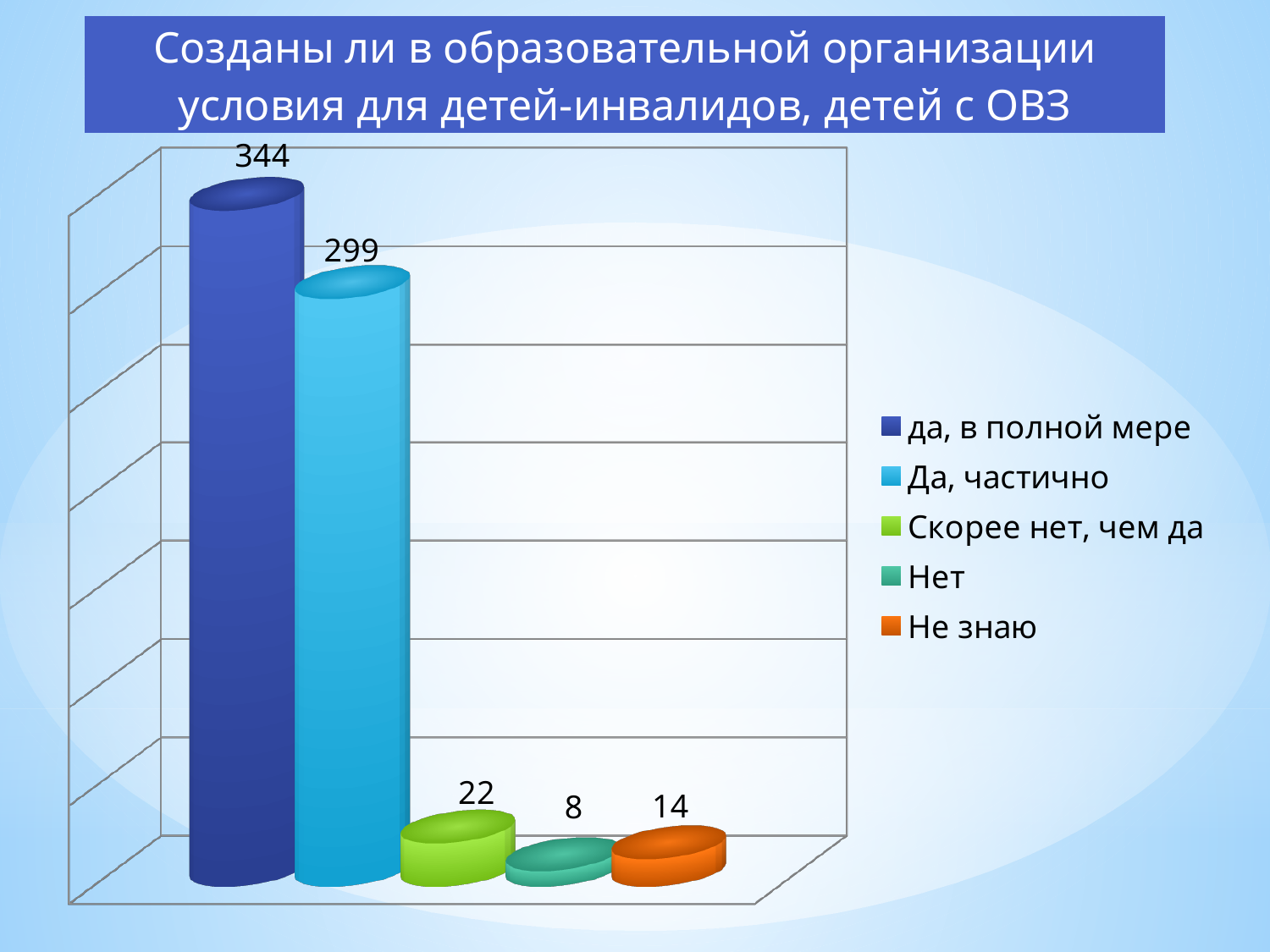
Which is larger, the value for "Не знаю" or the value for "Нет"? Не знаю What is the value for "да, в полной мере"? 344 What is the difference between the values for "да, в полной мере" and "Да, частично"? 45 What colour is the bar for "Не знаю"? orange Which category has the lowest value? Нет How many series does the legend list? 5 What is the value for "Да, частично"? 299 What is the value for "Не знаю"? 14 What is the value for "Скорее нет, чем да"? 22 Which category has the highest value? да, в полной мере What kind of chart is shown on the slide? bar chart What is the value for "Нет"? 8